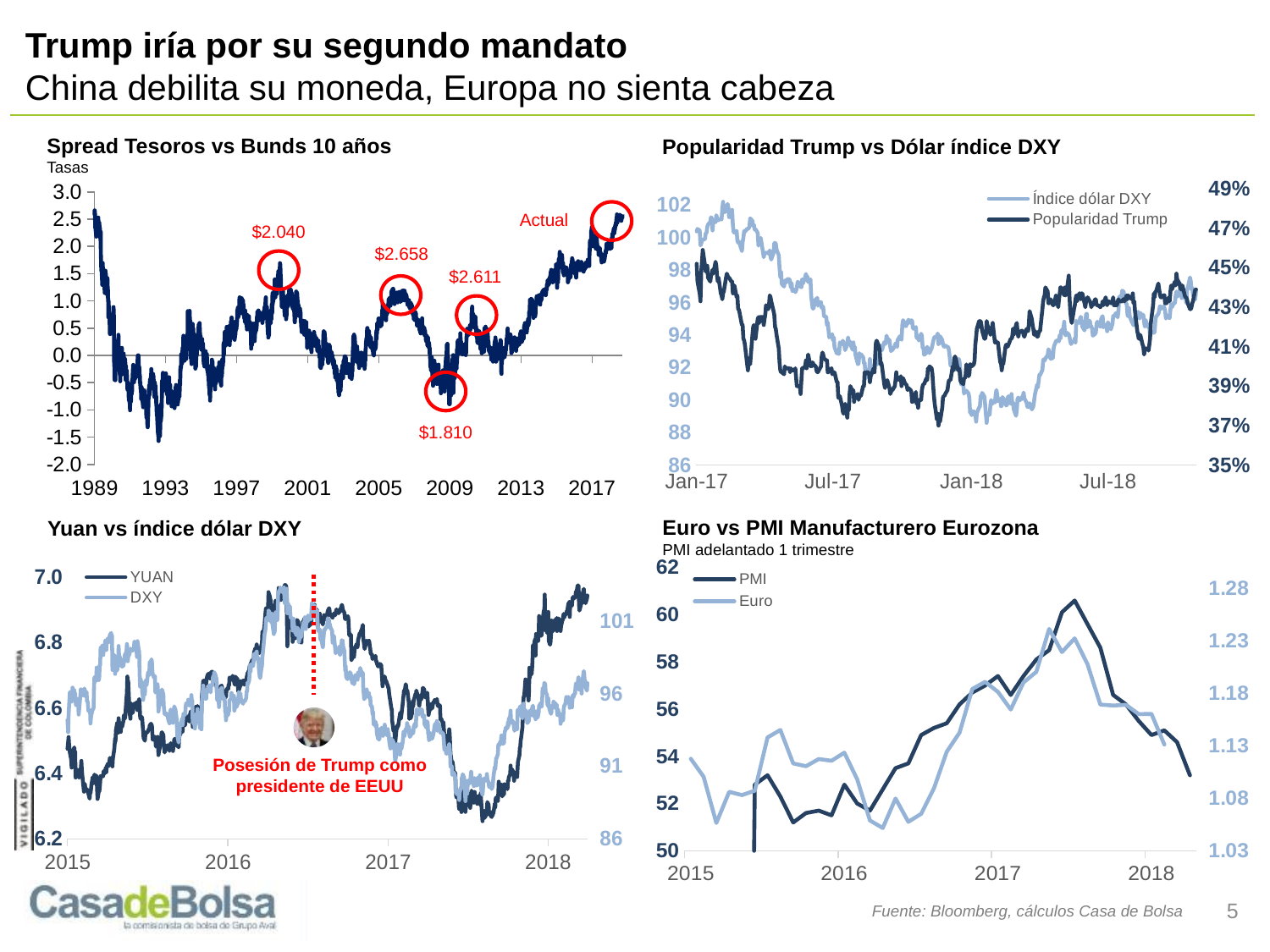
What subtitle appears under the title of the 'Euro vs PMI Manufacturero Eurozona' chart? PMI adelantado 1 trimestre What kind of chart is the 'Spread Tesoros vs Bunds 10 años' chart? line chart In the 'Spread Tesoros vs Bunds 10 años' chart, is the lowest point of the spread in the early 1990s greater or less than -1.0? less In the 'Popularidad Trump vs Dólar índice DXY' chart, is Popularidad Trump at Jan-17 greater or less than 41%? greater In the 'Spread Tesoros vs Bunds 10 años' chart, is the spread at the start of 1989 greater or less than 2.0? greater In the 'Popularidad Trump vs Dólar índice DXY' chart, does the Índice dólar DXY rise or fall between Jan-17 and Jan-18? fall In the 'Euro vs PMI Manufacturero Eurozona' chart, how many series does the legend list? 2 In the 'Popularidad Trump vs Dólar índice DXY' chart, how many series does the legend list? 2 In the 'Yuan vs índice dólar DXY' chart, what are the two legend entries? YUAN and DXY In the 'Yuan vs índice dólar DXY' chart, does the YUAN series rise or fall from 2015 to mid-2016? rise